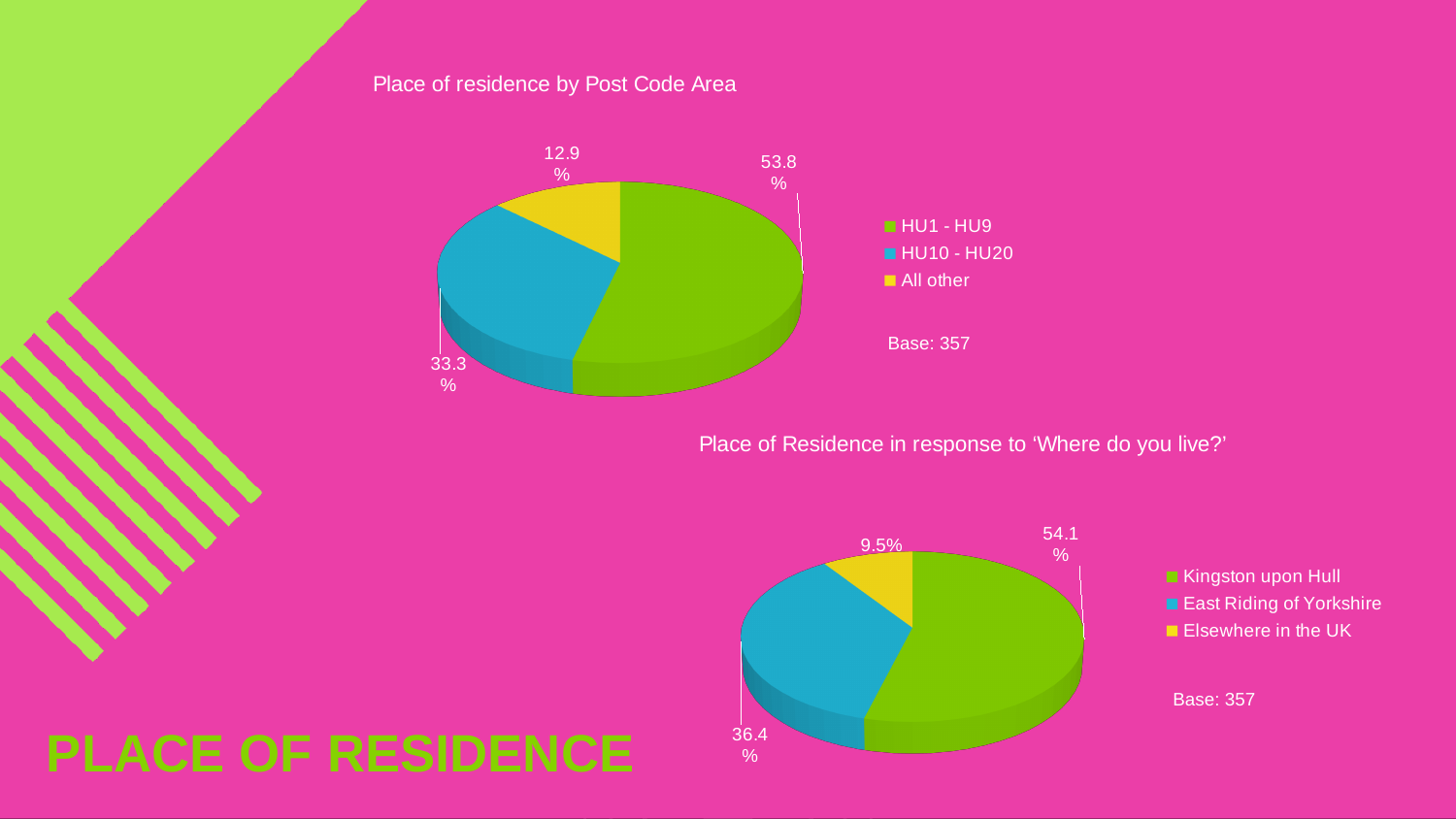
In the 'Place of residence by Post Code Area' chart, what share is shown for HU1 - HU9? 53.8% In the 'Place of residence by Post Code Area' chart, which category has the smallest slice? All other In the 'Place of residence by Post Code Area' chart, what share is shown for HU10 - HU20? 33.3% In the 'Place of residence by Post Code Area' chart, what is the difference between the HU1 - HU9 and HU10 - HU20 shares? 20.5% What base (sample size) is stated next to the 'Place of residence by Post Code Area' chart? Base: 357 In the 'Place of Residence in response to Where do you live?' chart, what share is shown for Elsewhere in the UK? 9.5% What type of chart is 'Place of residence by Post Code Area'? Pie chart In the 'Place of Residence in response to Where do you live?' chart, which category has the largest slice? Kingston upon Hull In the 'Place of Residence in response to Where do you live?' chart, what is the difference between the East Riding of Yorkshire and Elsewhere in the UK shares? 26.9% In the 'Place of Residence in response to Where do you live?' chart, what share is shown for Kingston upon Hull? 54.1% In the 'Place of Residence in response to Where do you live?' chart, which is larger: East Riding of Yorkshire or Elsewhere in the UK? East Riding of Yorkshire In the 'Place of residence by Post Code Area' chart, how many categories does the legend list? 3